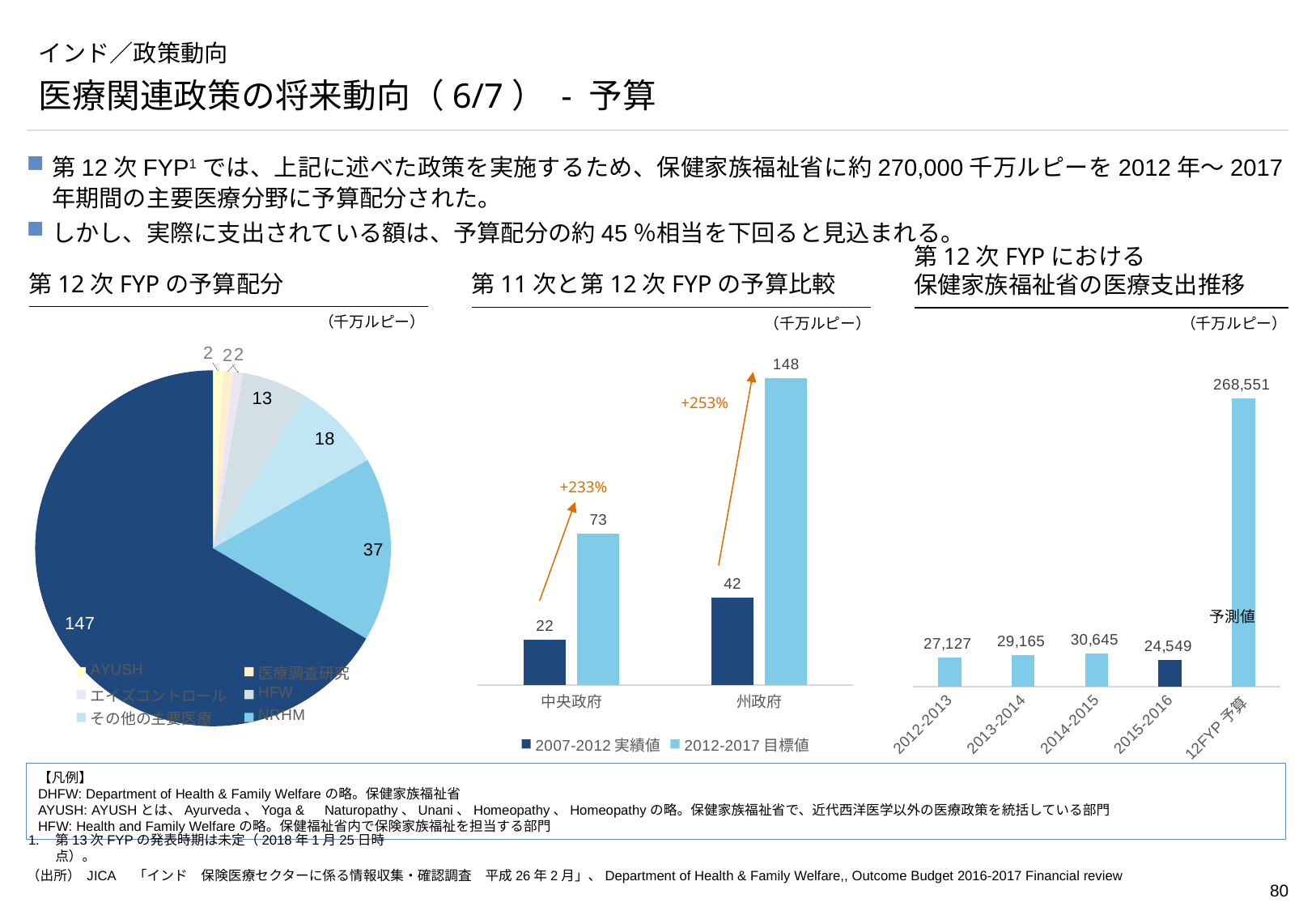
In the chart titled 第11次と第12次FYPの予算比較, what is the 2007-2012 実績値 value for 中央政府? 22 In the chart titled 第12次FYPにおける保健家族福祉省の医療支出推移, how many categories are shown on the x axis? 5 What kind of chart is the one titled 第12次FYPの予算配分? pie chart In the chart titled 第12次FYPにおける保健家族福祉省の医療支出推移, which category has the highest value? 12FYP予算 In the chart titled 第11次と第12次FYPの予算比較, how many series does the legend list? 2 In the chart titled 第11次と第12次FYPの予算比較, what is the difference between the 2012-2017 目標値 and the 2007-2012 実績値 for 中央政府? 51 In the chart titled 第11次と第12次FYPの予算比較, what is the 2012-2017 目標値 value for 州政府? 148 In the chart titled 第11次と第12次FYPの予算比較, what percentage increase is shown above the 州政府 bars? +253% In the chart titled 第12次FYPにおける保健家族福祉省の医療支出推移, what is the value for 2014-2015? 30,645 In the pie chart titled 第12次FYPの予算配分, what is the value of the largest slice? 147 In the chart titled 第12次FYPにおける保健家族福祉省の医療支出推移, is the value for 2013-2014 larger or smaller than the value for 2012-2013? larger In the chart titled 第12次FYPにおける保健家族福祉省の医療支出推移, which category has the lowest value? 2015-2016